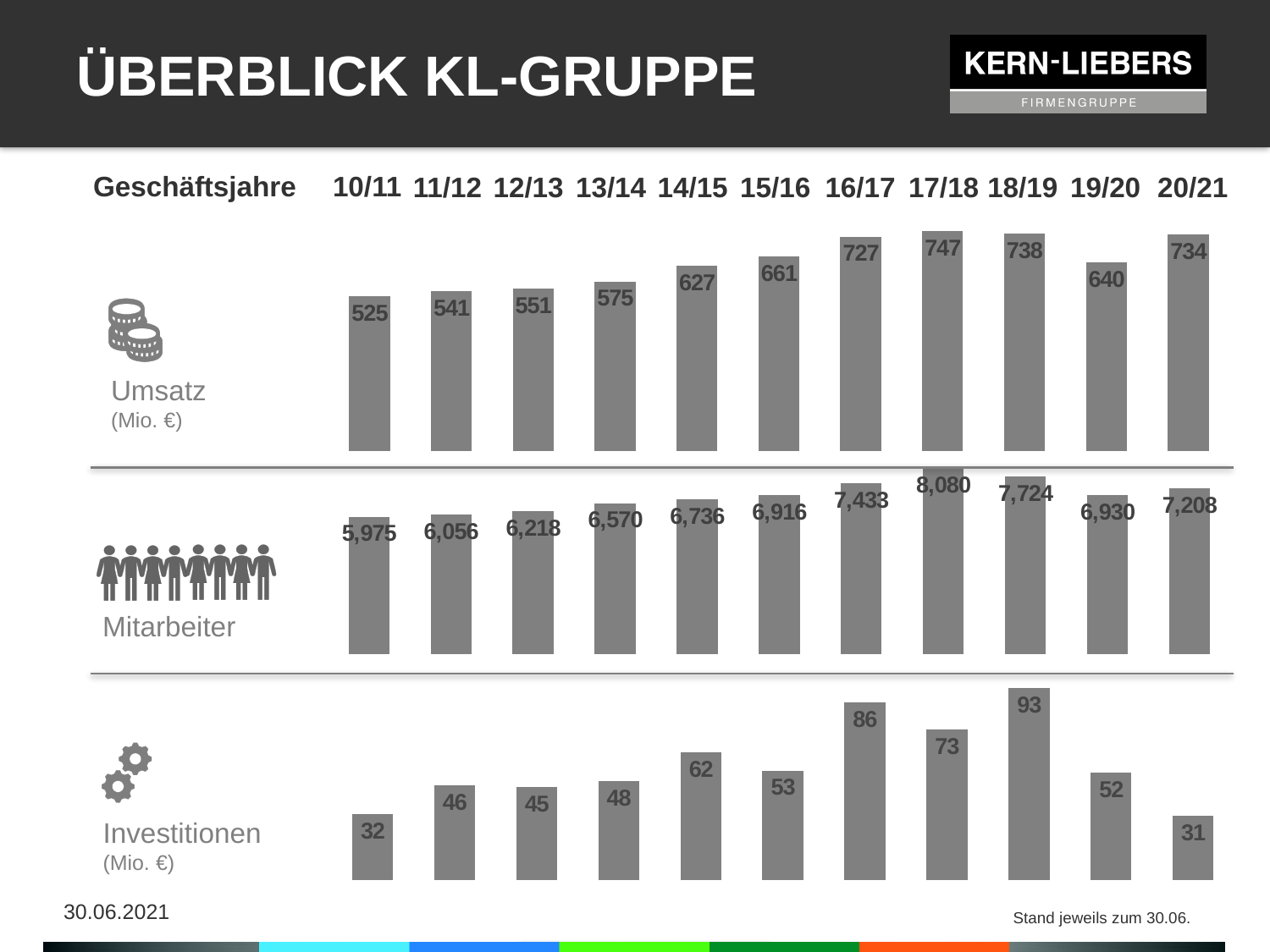
In the Investitionen chart, which year has the highest value? 18/19 In the Mitarbeiter chart, what is the value for 20/21? 7,208 In the Mitarbeiter chart, what is the difference between the values for 17/18 and 18/19? 356 In the Umsatz chart, what is the difference between the values for 17/18 and 10/11? 222 In the Investitionen chart, what is the value for 14/15? 62 In the Umsatz chart, which year has the lowest value? 10/11 In the Umsatz chart, what is the value for 17/18? 747 In the Mitarbeiter chart, which year has the highest value? 17/18 What kind of chart is the Investitionen chart? bar chart How many years (categories) are shown in the Umsatz chart? 11 In the Umsatz chart, do the values rise or fall from 10/11 to 17/18? rise In the Investitionen chart, which is larger, the value for 16/17 or the value for 17/18? 16/17